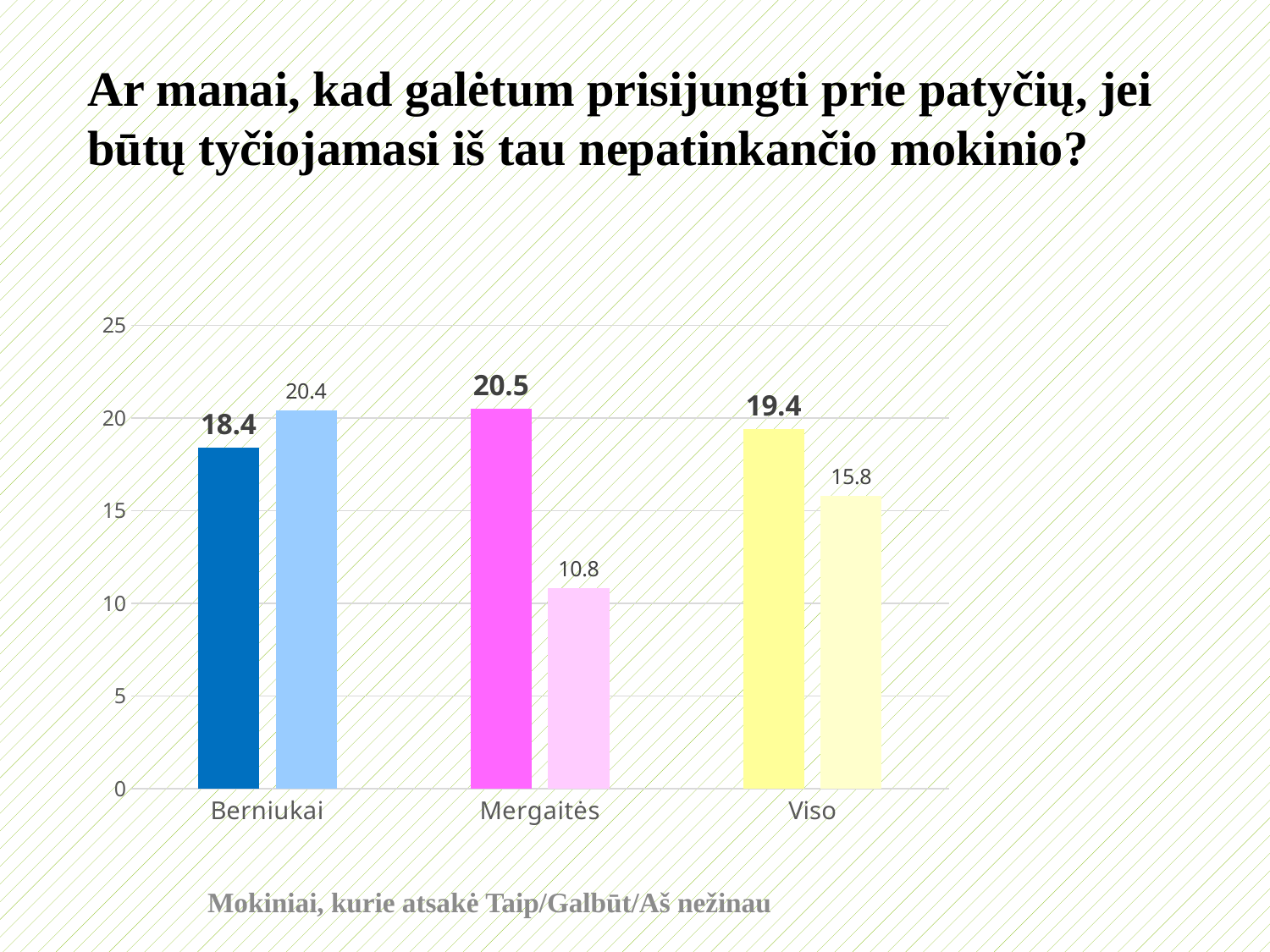
Which category has the lowest bar in the chart? Mergaitės What is the value of the first (darker) bar for Mergaitės? 20.5 What is the difference between the two bars for Viso? 3.6 What is the difference between the two bars for Mergaitės? 9.7 What is the value of the second (lighter) bar for Berniukai? 20.4 What kind of chart is shown on the slide? bar chart Which is larger for Berniukai: the first (darker) bar or the second (lighter) bar? the second (lighter) bar What is the value of the second (lighter) bar for Mergaitės? 10.8 What text appears below the chart? Mokiniai, kurie atsakė Taip/Galbūt/Aš nežinau What is the value of the second (lighter) bar for Viso? 15.8 How many categories are shown on the x axis of the chart? 3 What is the value of the first (darker) bar for Berniukai? 18.4